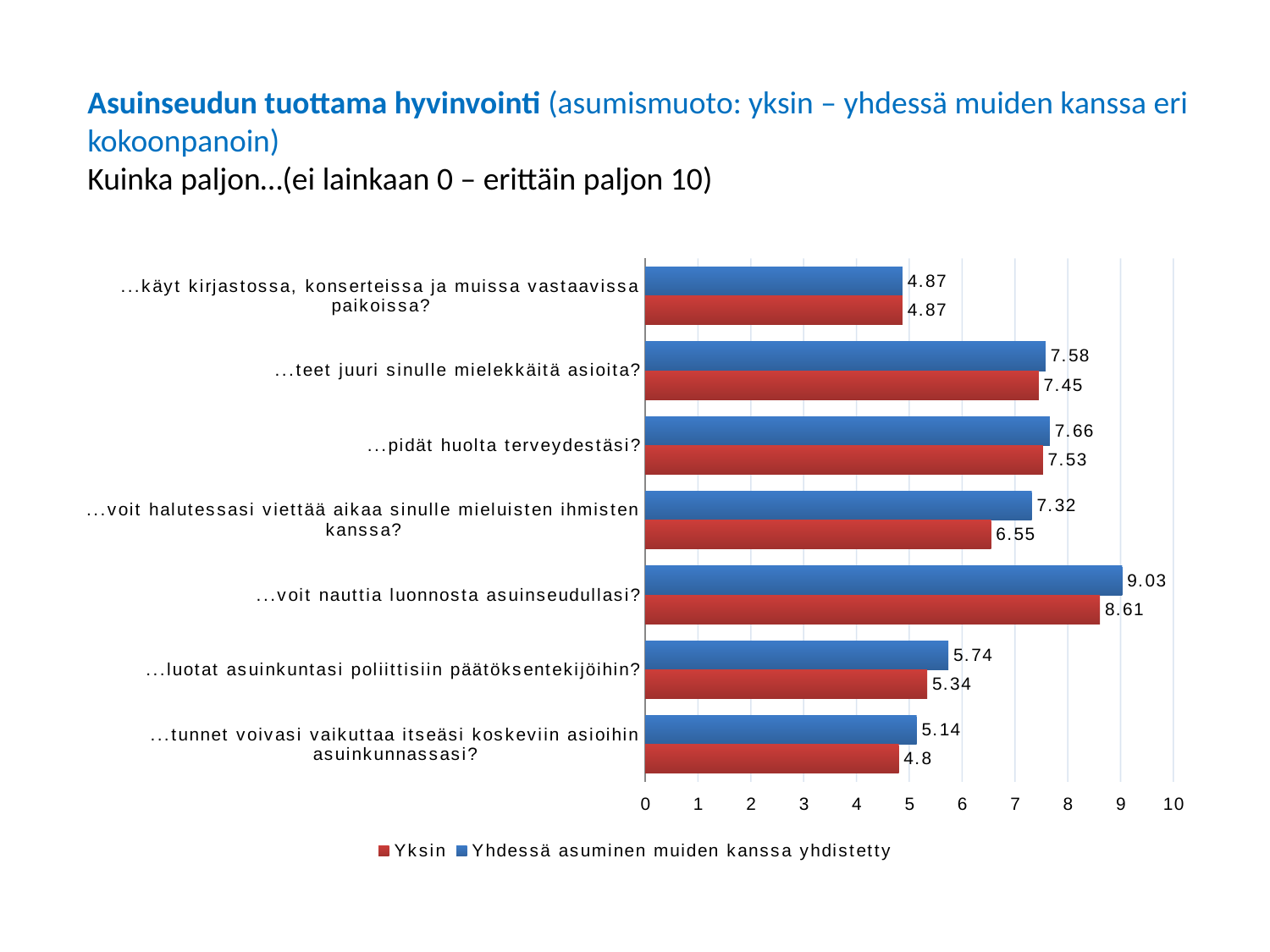
How many categories (questions) are shown on the chart? 7 What is the value for 'Yksin' for '...voit nauttia luonnosta asuinseudullasi?'? 8.61 How many series does the legend list? 2 Which category has the highest value for 'Yhdessä asuminen muiden kanssa yhdistetty'? ...voit nauttia luonnosta asuinseudullasi? What is the difference between the 'Yhdessä asuminen muiden kanssa yhdistetty' and 'Yksin' values for '...voit halutessasi viettää aikaa sinulle mieluisten ihmisten kanssa?'? 0.77 What is the value for 'Yksin' for '...tunnet voivasi vaikuttaa itseäsi koskeviin asioihin asuinkunnassasi?'? 4.8 For '...luotat asuinkuntasi poliittisiin päätöksentekijöihin?', which series has the larger value, 'Yksin' or 'Yhdessä asuminen muiden kanssa yhdistetty'? Yhdessä asuminen muiden kanssa yhdistetty What is the value for 'Yhdessä asuminen muiden kanssa yhdistetty' for '...voit halutessasi viettää aikaa sinulle mieluisten ihmisten kanssa?'? 7.32 Which category has the lowest value for 'Yksin'? ...tunnet voivasi vaikuttaa itseäsi koskeviin asioihin asuinkunnassasi? Is the 'Yksin' value for '...pidät huolta terveydestäsi?' greater or less than 7? greater What kind of chart is shown on the slide? bar chart Which colour represents the 'Yksin' series in the chart? red